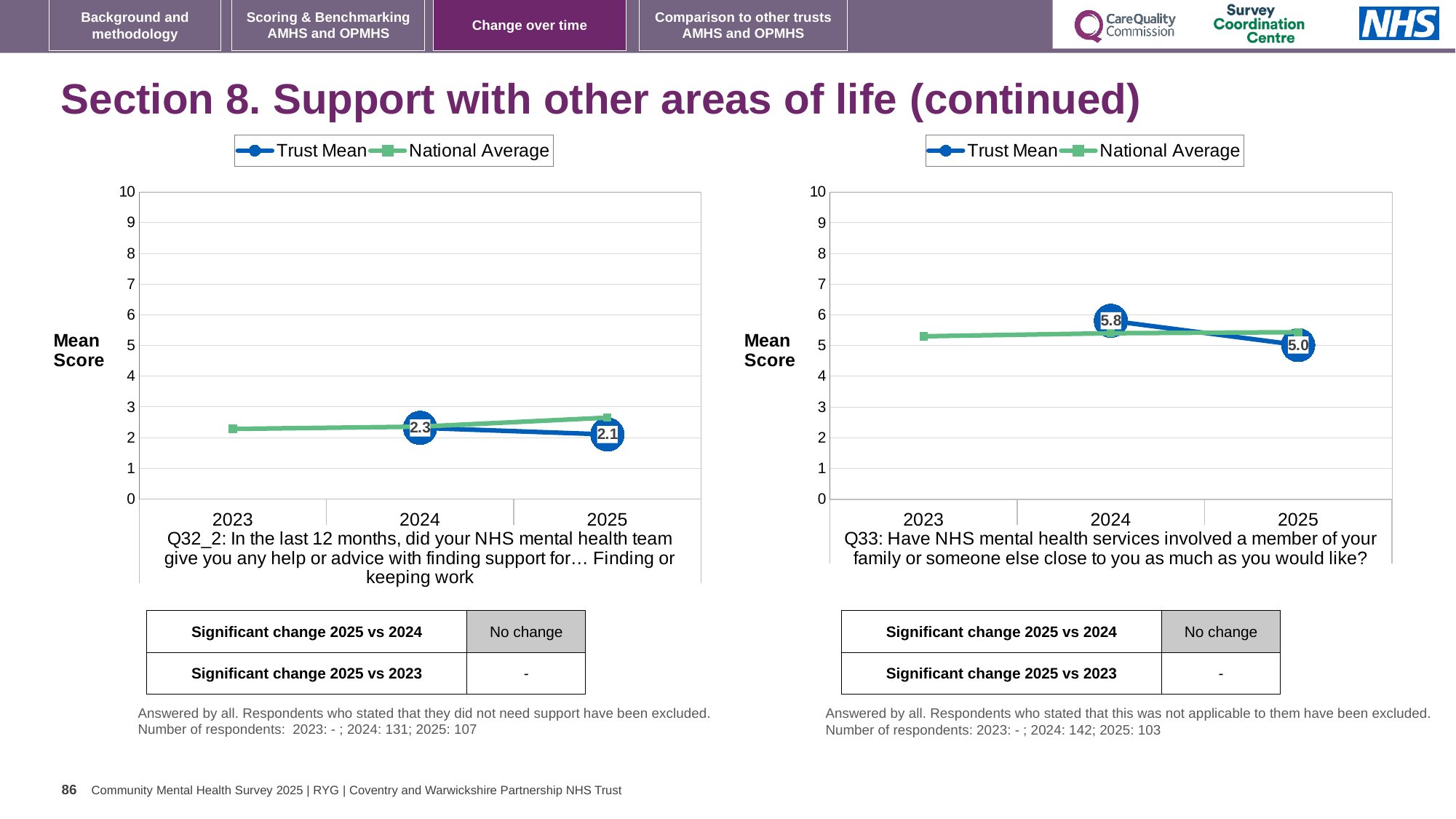
What kind of chart is the left chart (Q32_2)? line chart In the left chart (Q32_2), what is the Trust Mean value for 2025? 2.1 In the left chart (Q32_2), what is the Trust Mean value for 2024? 2.3 In the right chart (Q33), by how much did the Trust Mean fall from 2024 to 2025? 0.8 In the right chart (Q33), what is the Trust Mean value for 2024? 5.8 In the right chart (Q33), does the Trust Mean rise or fall from 2024 to 2025? fall In the left chart (Q32_2), is the National Average value for 2025 greater or less than 3? less In the left chart (Q32_2), what is the difference between the Trust Mean in 2024 and in 2025? 0.2 In the right chart (Q33), what is the Trust Mean value for 2025? 5.0 How many years are shown on the x axis of the left chart (Q32_2)? 3 How many series does the legend of the right chart (Q33) list? 2 In the right chart (Q33), is the Trust Mean higher in 2024 or in 2025? 2024